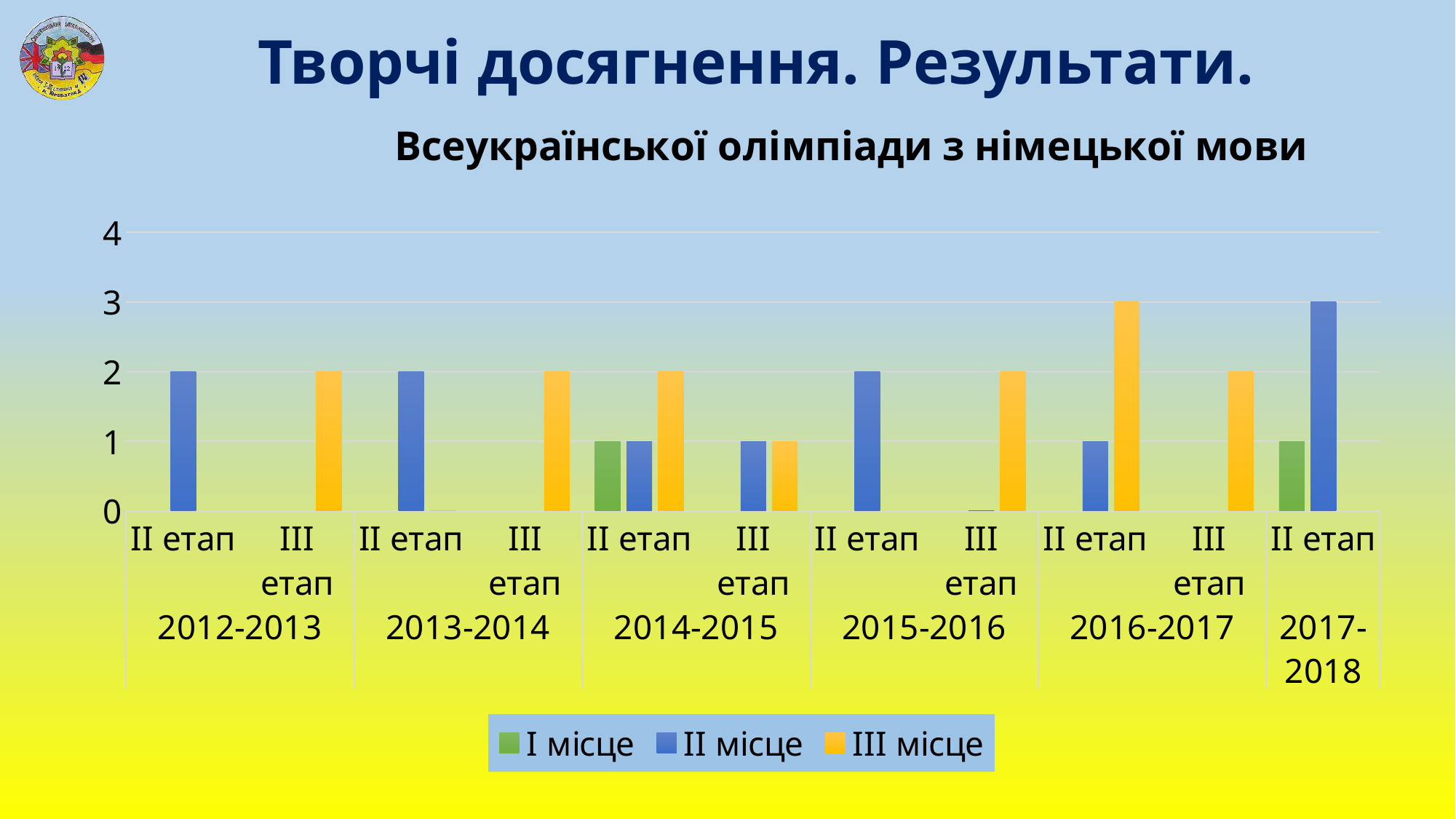
How many series does the legend list? 3 What kind of chart is shown on the slide? bar chart What are the three series listed in the legend? I місце, II місце, III місце What is the value of III місце for II етап in 2016-2017? 3 Which is larger for II етап in 2016-2017: II місце or III місце? III місце What is the value of II місце for II етап in 2012-2013? 2 What is the difference between III місце and II місце for II етап in 2016-2017? 2 What is the value of III місце for III етап in 2015-2016? 2 What is the value of II місце for II етап in 2017-2018? 3 What is the highest value shown on the vertical axis? 4 In which year does II місце reach its highest value? 2017-2018 What is the value of I місце for II етап in 2014-2015? 1